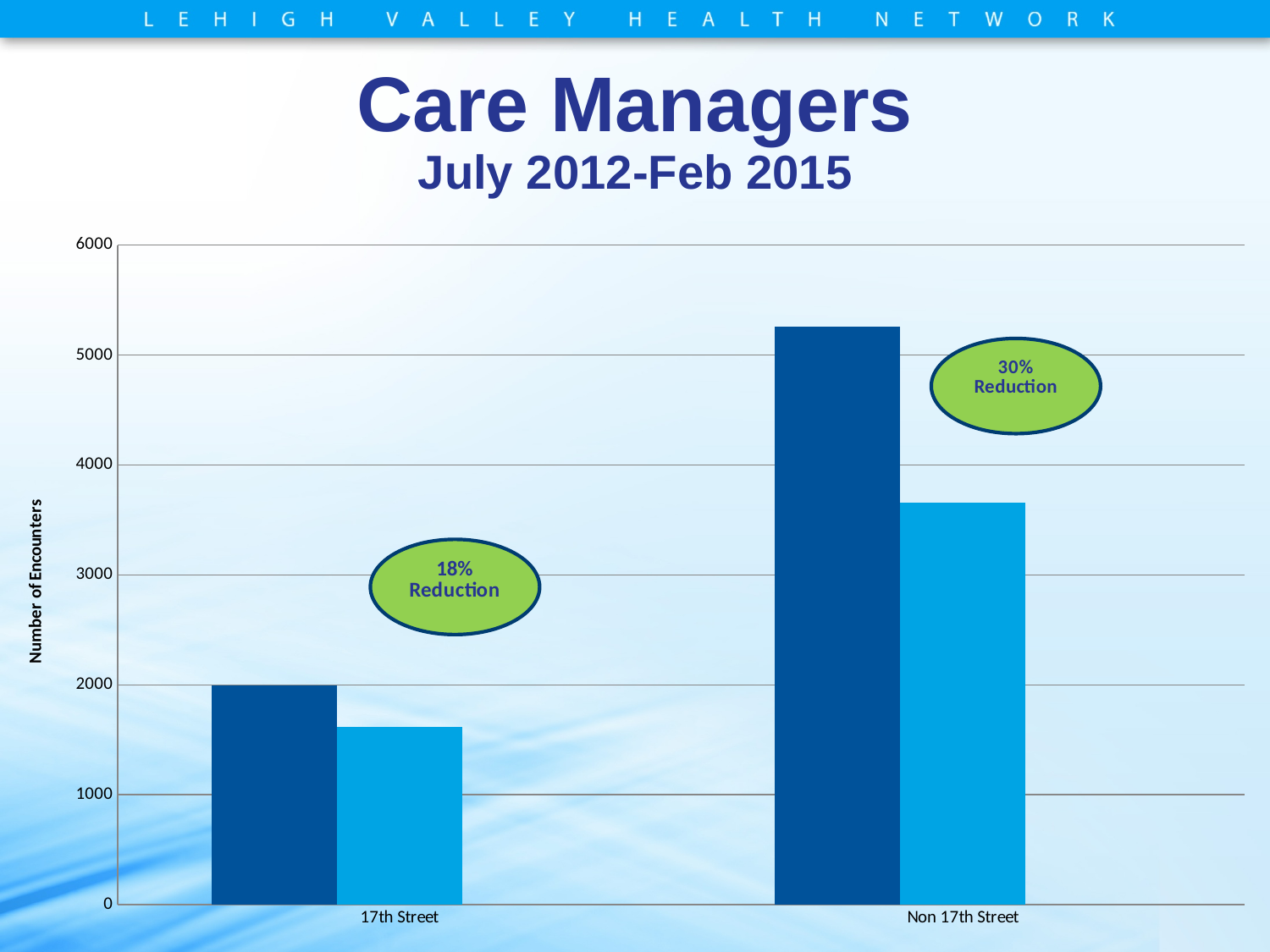
For Non 17th Street, which bar is taller, the dark blue bar or the light blue bar? dark blue bar Is the value of the light blue bar for 17th Street greater or less than 1000? greater Is the value of the dark blue bar for Non 17th Street greater or less than 5000? greater Is the value of the light blue bar for 17th Street greater or less than 2000? less What is the title of the chart on the slide? Care Managers July 2012-Feb 2015 What kind of chart is shown on the slide? bar chart Which category has the tallest bar in the chart? Non 17th Street What percentage reduction is annotated for Non 17th Street? 30% Reduction What is the label of the vertical axis? Number of Encounters Which category has the shortest bar in the chart? 17th Street How many categories are shown on the x axis of the chart? 2